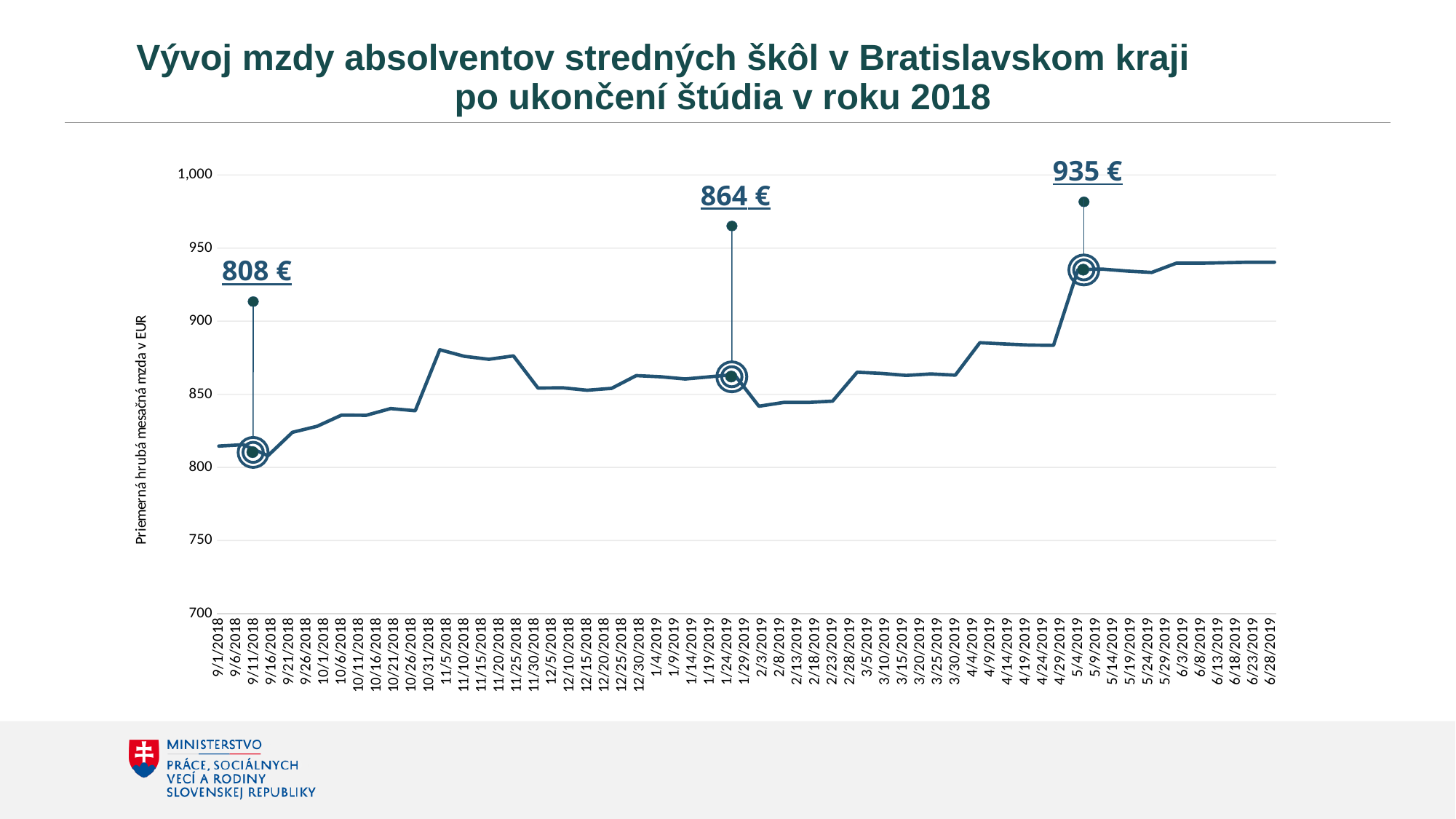
What is the difference between the labelled values for 5/4/2019 and 9/11/2018? 127 € What value is labelled for 9/11/2018? 808 € Which is larger, the labelled value for 1/24/2019 or for 5/4/2019? 5/4/2019 What value is labelled for 1/24/2019? 864 € Is the value for 11/5/2018 greater or less than 850? greater Which of the three labelled points has the lowest value? 9/11/2018 (808 €) Is the value for 6/28/2019 greater or less than 900? greater What value is labelled for 5/4/2019? 935 € What is the difference between the labelled values for 1/24/2019 and 9/11/2018? 56 € Do the values generally rise or fall from 9/1/2018 to 6/28/2019? rise What kind of chart is shown on the slide? line chart Which of the three labelled points has the highest value? 5/4/2019 (935 €)